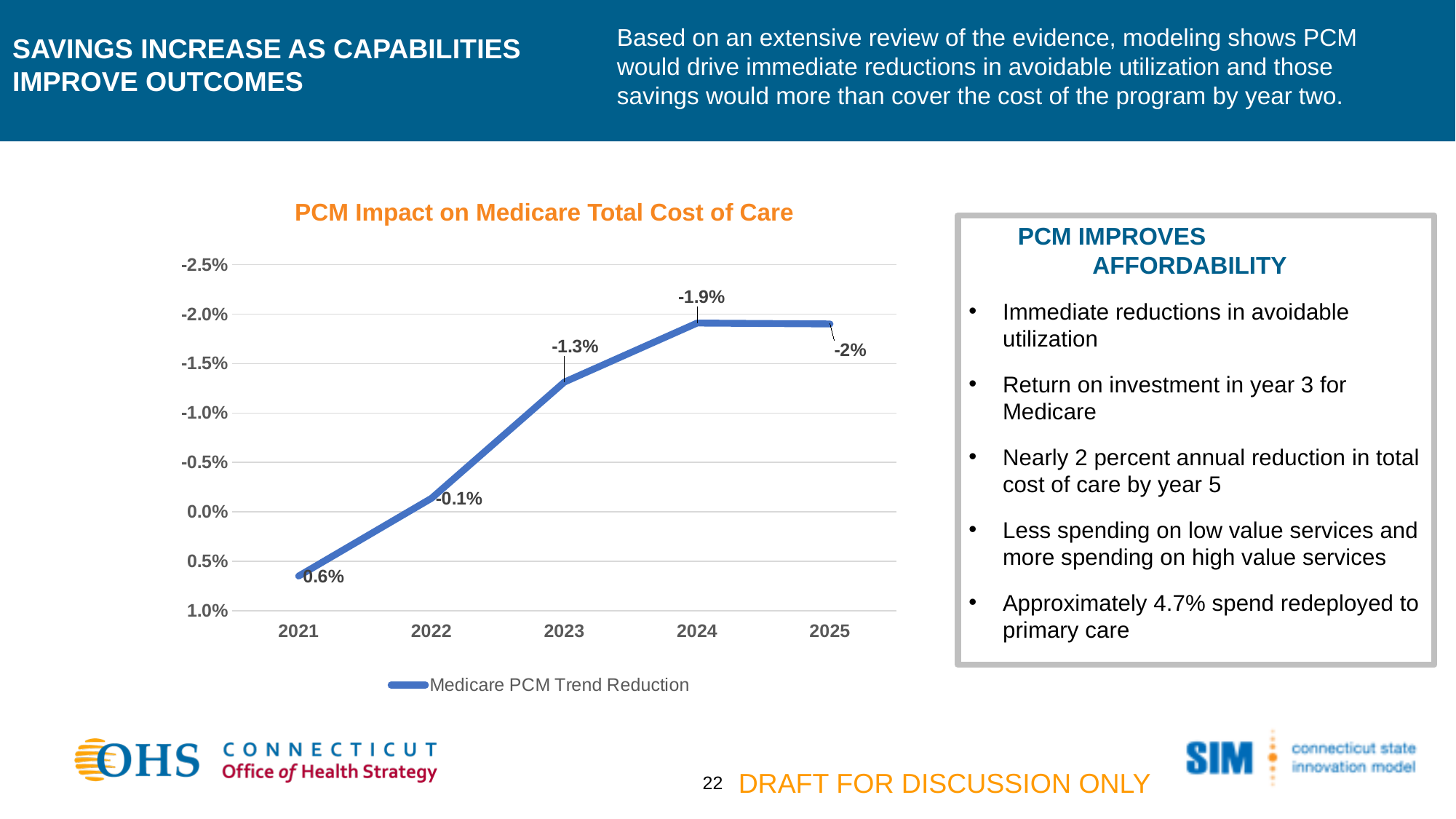
What is the difference between the 2024 value and the 2023 value in the PCM Impact on Medicare Total Cost of Care chart? 0.6 percentage points What is the value for 2025 in the PCM Impact on Medicare Total Cost of Care chart? -2% Which year has the lowest value in the PCM Impact on Medicare Total Cost of Care chart? 2025 How many series does the legend of the PCM Impact on Medicare Total Cost of Care chart list? 1 What is the value for 2021 in the PCM Impact on Medicare Total Cost of Care chart? 0.6% What is the name of the series shown in the legend of the PCM Impact on Medicare Total Cost of Care chart? Medicare PCM Trend Reduction What is the value for 2023 in the PCM Impact on Medicare Total Cost of Care chart? -1.3% Which is larger in the PCM Impact on Medicare Total Cost of Care chart, the value for 2022 or the value for 2023? 2022 How many years are plotted in the PCM Impact on Medicare Total Cost of Care chart? 5 Which year has the highest value in the PCM Impact on Medicare Total Cost of Care chart? 2021 What is the value for 2022 in the PCM Impact on Medicare Total Cost of Care chart? -0.1% What kind of chart is the PCM Impact on Medicare Total Cost of Care chart? Line chart